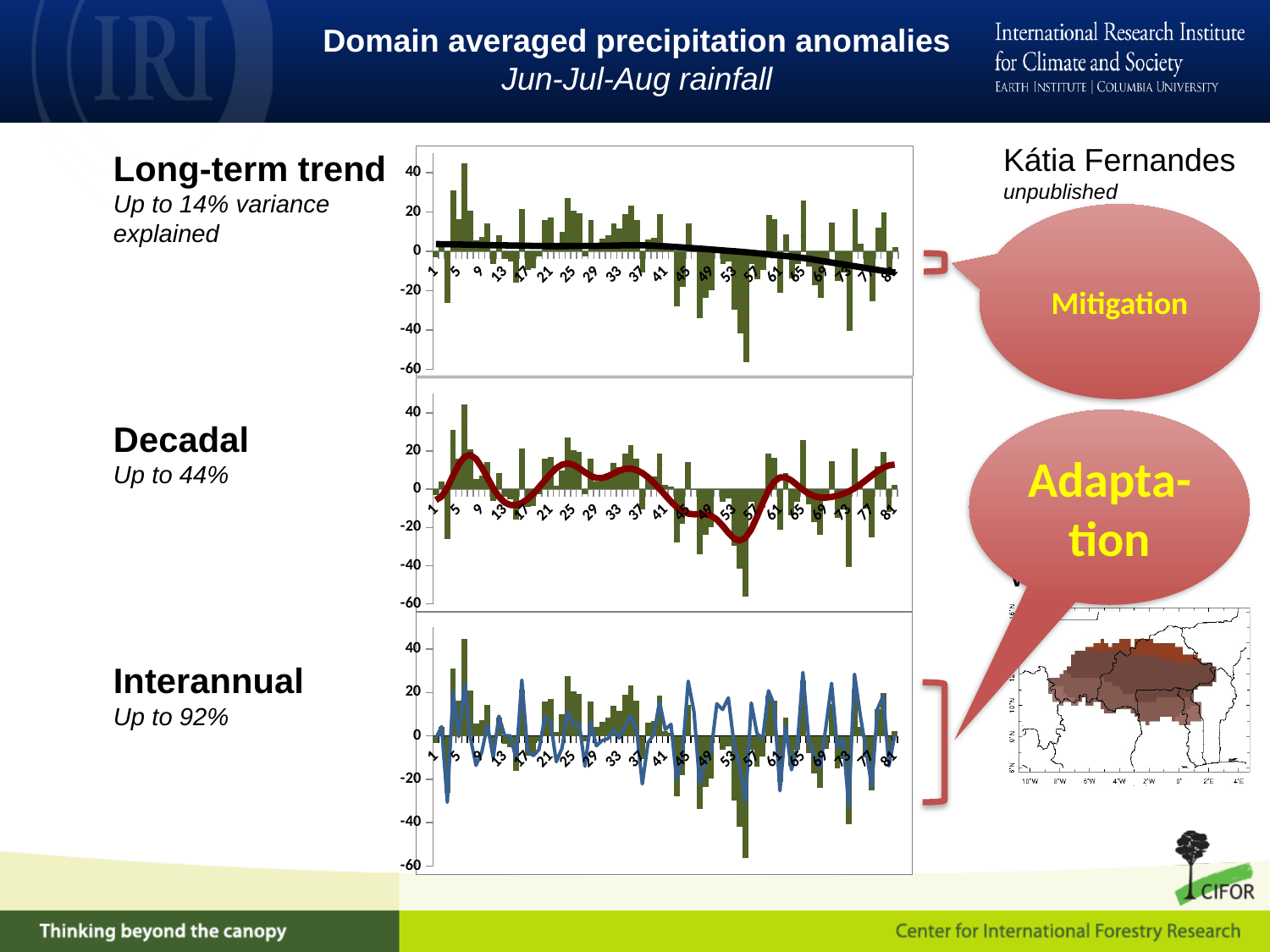
In the top chart (Long-term trend), is the tallest bar (near x = 5) greater or less than 20? greater What is the lowest value shown on the y axis of the bottom chart (Interannual)? -60 In the top chart (Long-term trend), is the lowest bar (near x = 57) greater or less than -40? less In the bottom chart (Interannual), is the tallest bar (near x = 5) greater or less than 0? greater How many charts are shown on the slide? 3 What is the highest value shown on the y axis of the top chart (Long-term trend)? 40 In the top chart (Long-term trend), does the black trend line rise or fall from left to right? fall In the top chart (Long-term trend), is the bar near x = 5 taller than the bar near x = 9? yes What kind of chart is the top chart labelled "Long-term trend"? bar chart with a trend line (combination bar and line chart)